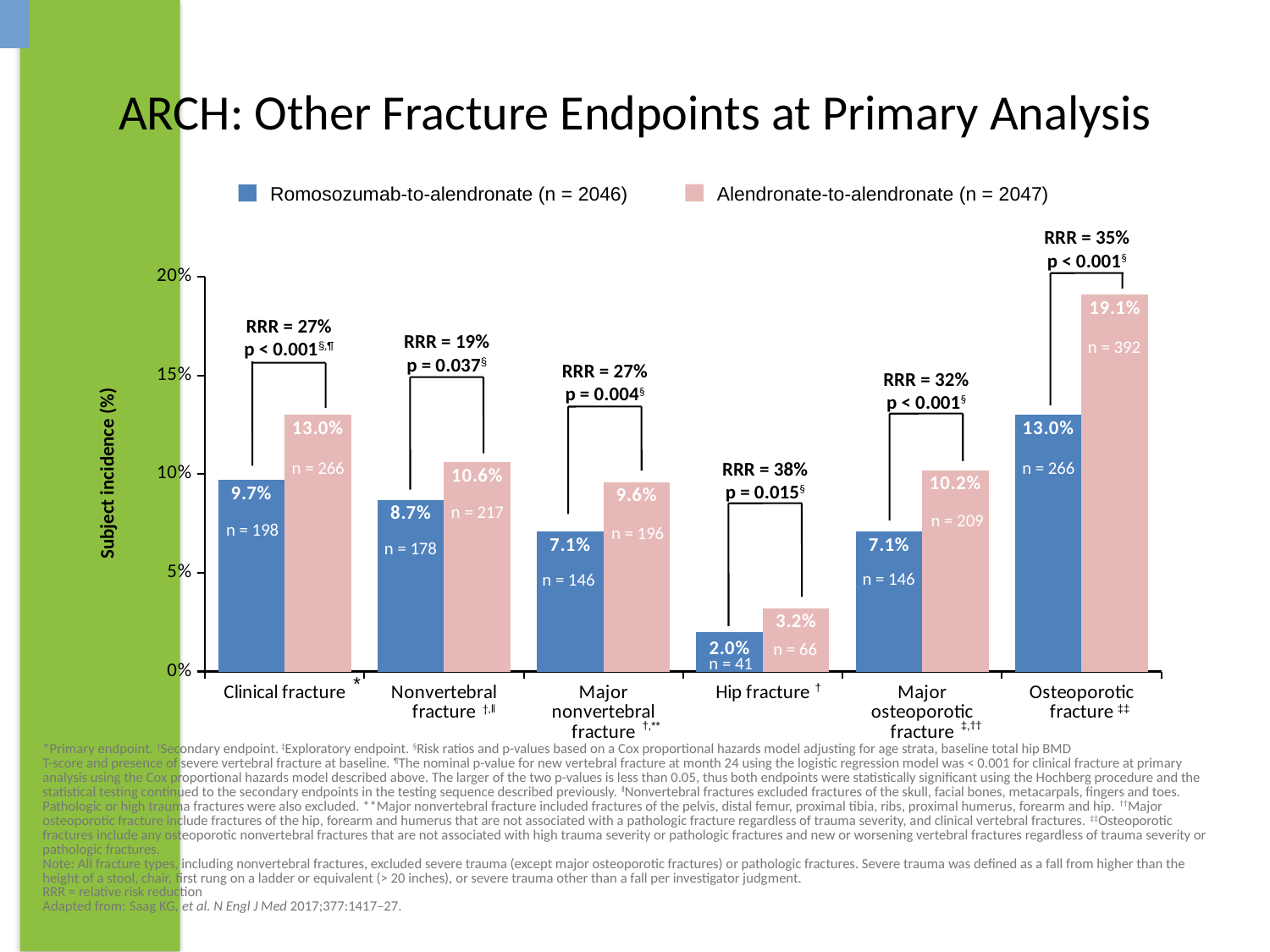
What is the subject incidence for Romosozumab-to-alendronate in the Clinical fracture category? 9.7% How many series does the legend list? 2 Which fracture category has the highest subject incidence for the Alendronate-to-alendronate group? Osteoporotic fracture What is the subject incidence for Alendronate-to-alendronate in the Osteoporotic fracture category? 19.1% What is the difference in subject incidence between the two groups for Major osteoporotic fracture? 3.1% How many patients (n) had a nonvertebral fracture in the Romosozumab-to-alendronate group? n = 178 How many fracture categories are shown on the x axis? 6 What is the relative risk reduction (RRR) shown for Hip fracture? RRR = 38% For Major nonvertebral fracture, which group has the higher subject incidence? Alendronate-to-alendronate Which fracture category has the lowest subject incidence for the Romosozumab-to-alendronate group? Hip fracture What is the difference in subject incidence between the two groups for Osteoporotic fracture? 6.1% What is the subject incidence for Alendronate-to-alendronate in the Hip fracture category? 3.2%